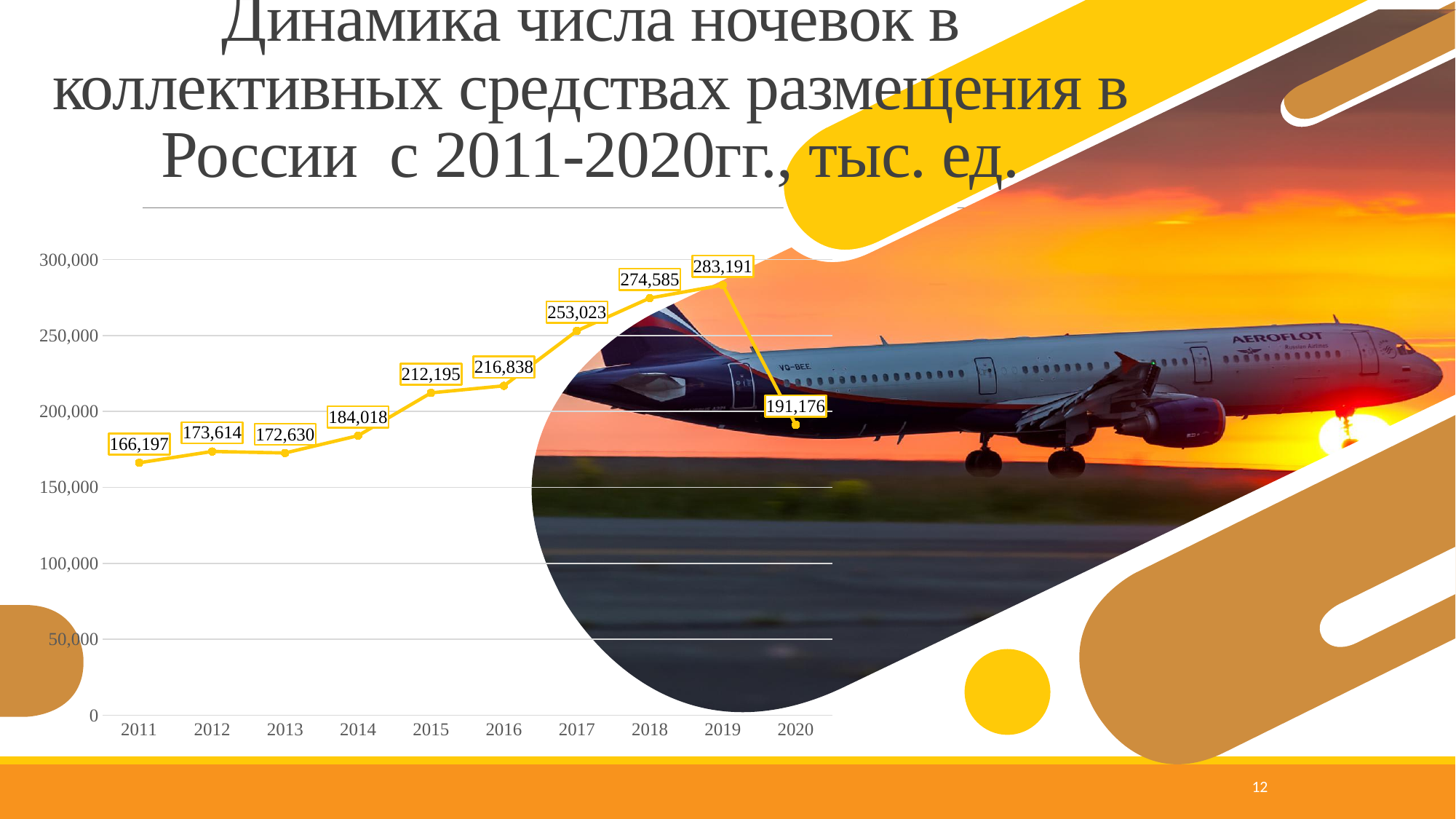
What is the value for 2020? 191,176 How many years are plotted on the x axis? 10 Which year has the highest value? 2019 Do the values rise or fall from 2011 to 2019? rise What is the difference between the values for 2015 and 2014? 28,177 What is the difference between the values for 2019 and 2020? 92,015 Is the value for 2018 greater or less than 250,000? greater Which year has the lowest value? 2011 What is the value for 2011? 166,197 What is the value for 2017? 253,023 Which is larger, the value for 2012 or the value for 2013? 2012 What type of chart is shown on the slide? line chart